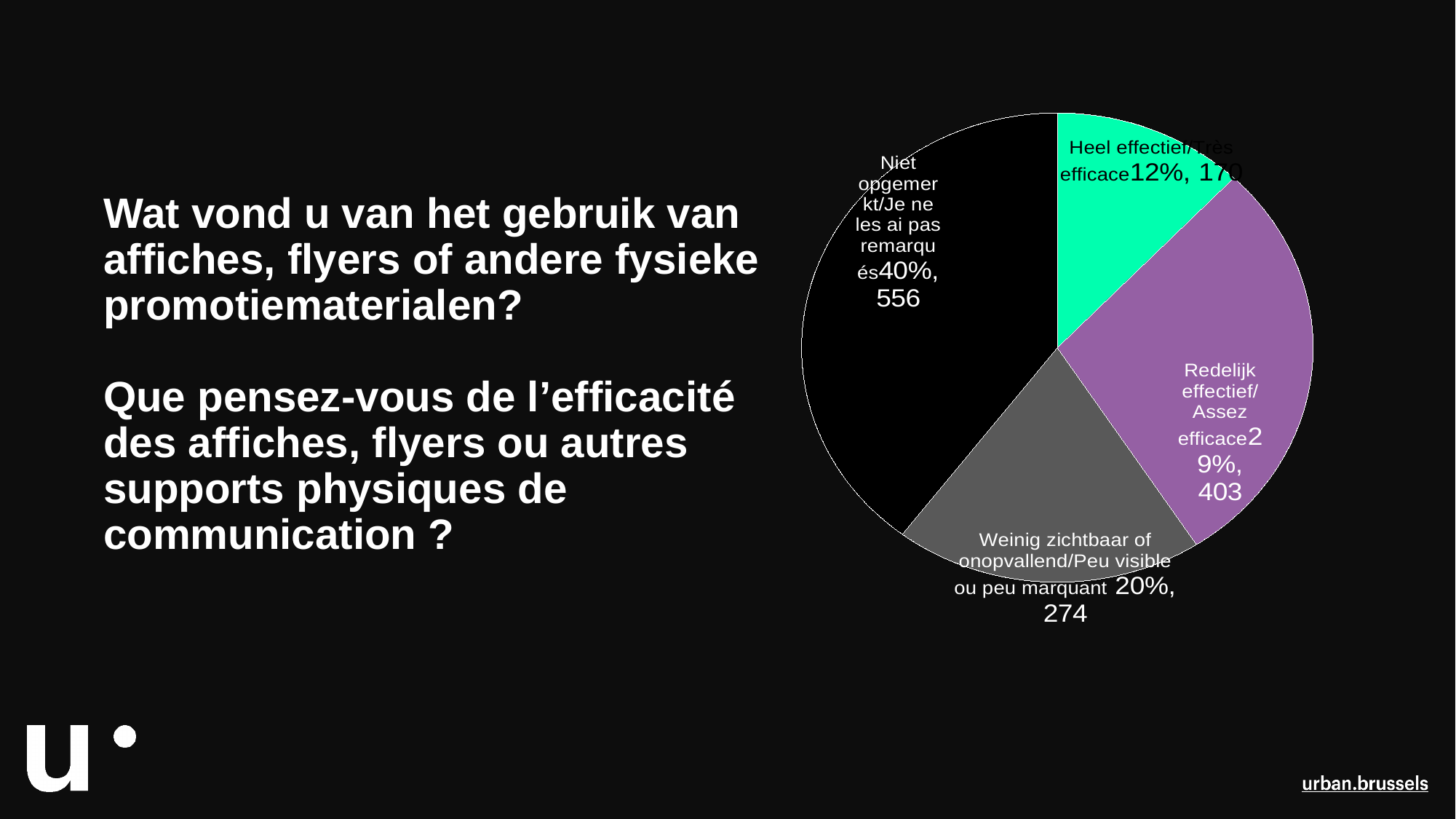
Which slice of the pie chart is the smallest? Heel effectief/Très efficace What count is shown for the 'Niet opgemerkt/Je ne les ai pas remarqués' slice? 556 How many slices does the pie chart have? 4 What share of the pie does the 'Redelijk effectief/Assez efficace' slice represent? 29% Which slice of the pie chart is the largest? Niet opgemerkt/Je ne les ai pas remarqués What kind of chart is shown on the slide? pie chart What is the difference in count between 'Niet opgemerkt/Je ne les ai pas remarqués' and 'Redelijk effectief/Assez efficace'? 153 What percentage is shown for the 'Weinig zichtbaar of onopvallend/Peu visible ou peu marquant' slice? 20% Which has a larger count: 'Weinig zichtbaar of onopvallend/Peu visible ou peu marquant' or 'Heel effectief/Très efficace'? Weinig zichtbaar of onopvallend/Peu visible ou peu marquant What percentage is shown for the 'Heel effectief/Très efficace' slice? 12% What count is shown for the 'Redelijk effectief/Assez efficace' slice? 403 What colour is the 'Heel effectief/Très efficace' slice? green